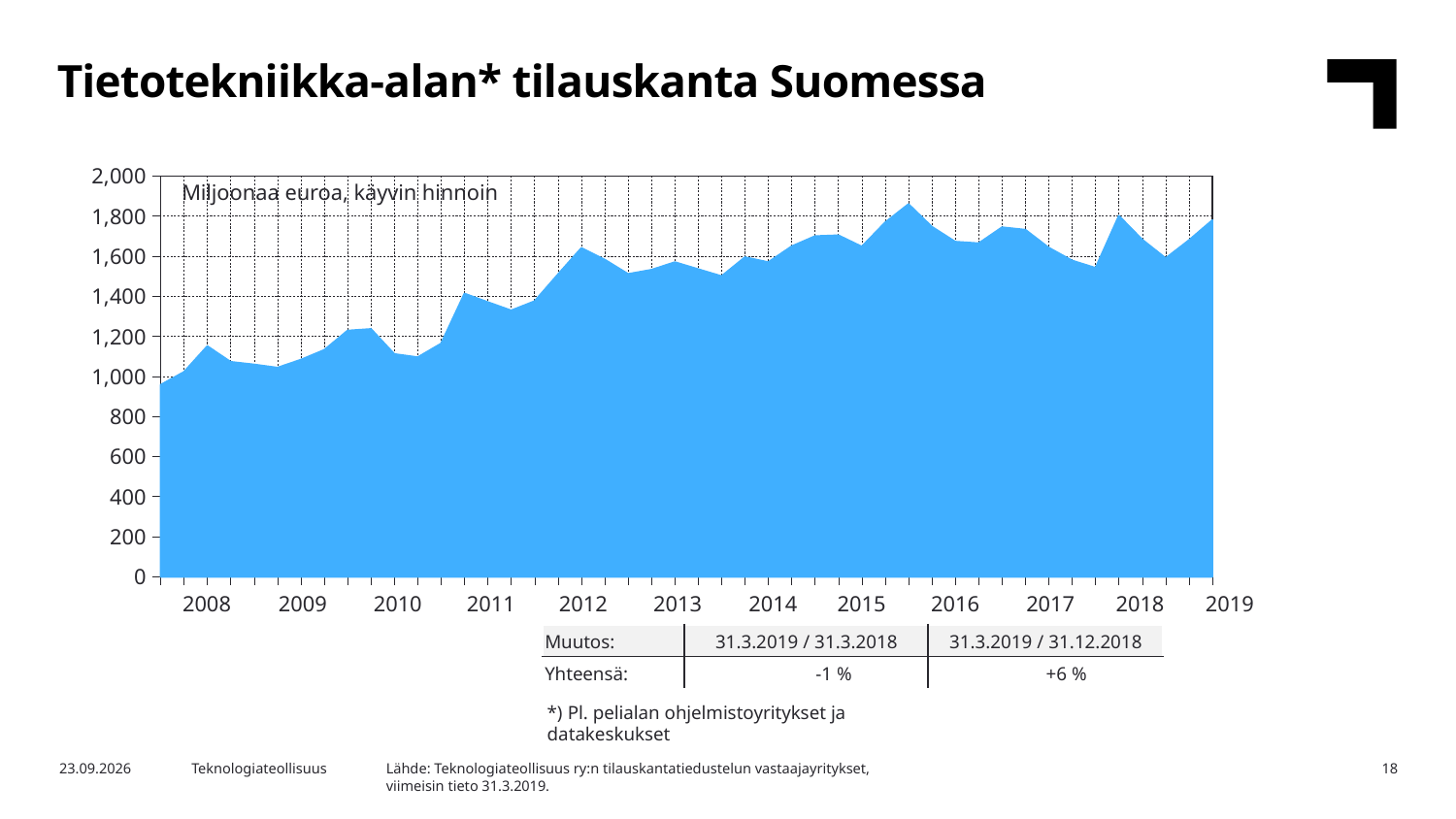
How many years are labelled on the x axis of the chart? 12 According to the table below the chart, what is the change (Muutos) for 31.3.2019 / 31.12.2018? +6 % What is the title of the chart on the slide? Tietotekniikka-alan* tilauskanta Suomessa Is the value at the start of the series in 2008 greater or less than 1,200? less What kind of chart is shown on the slide? area chart Is the value at 2012 greater or less than 1,400? greater In which year does the series reach its lowest value? 2008 In what unit are the values on the chart expressed, according to the label inside the plot area? Miljoonaa euroa, käyvin hinnoin Is the highest peak of the series, around 2015, greater or less than 1,800? greater Overall, do the values rise or fall from 2008 to 2019? rise